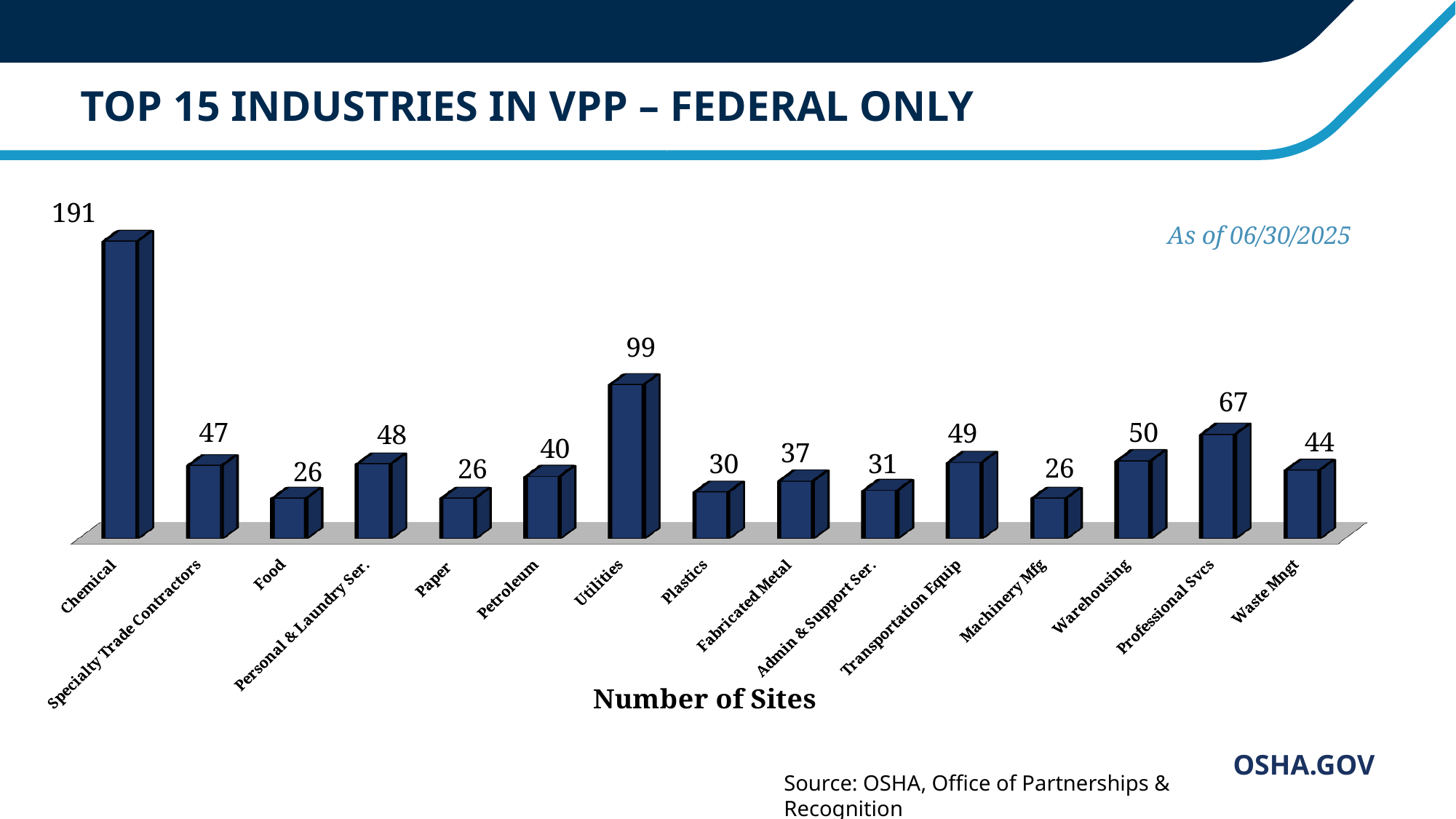
What kind of chart is shown on the slide? Bar chart Which industry has the highest number of sites? Chemical Which has more sites, Petroleum or Fabricated Metal? Petroleum What is the difference in number of sites between Chemical and Utilities? 92 What is the number of sites for Admin & Support Ser.? 31 What is the number of sites for Chemical? 191 Which has more sites, Transportation Equip or Waste Mngt? Transportation Equip What is the number of sites for Professional Svcs? 67 How many industries are shown in the chart? 15 What is the number of sites for Utilities? 99 What is the title of the chart on the slide? Top 15 Industries in VPP – Federal Only What is the difference in number of sites between Professional Svcs and Warehousing? 17